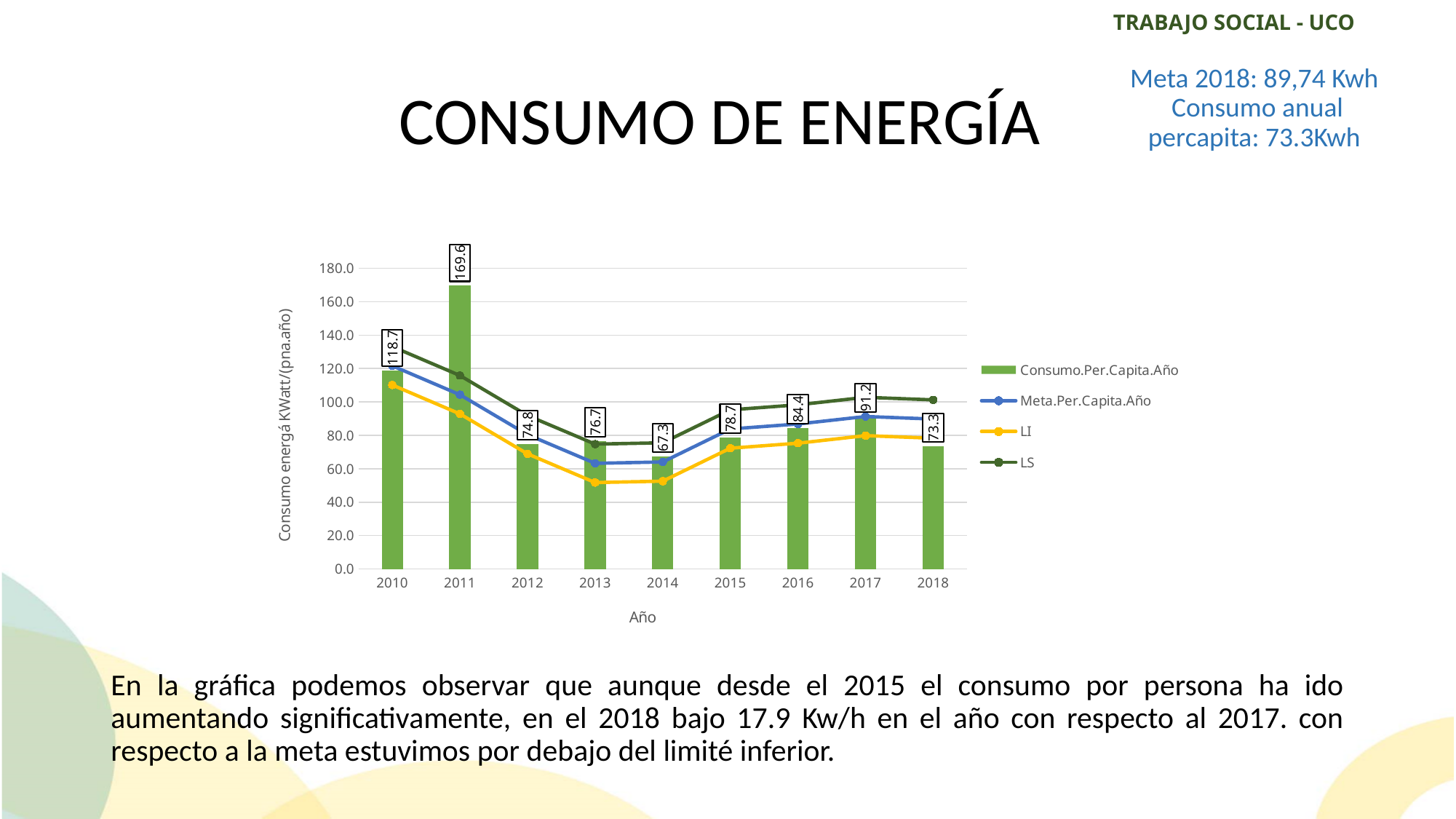
Do the Consumo.Per.Capita.Año bars rise or fall from 2014 to 2017? rise Which year has the highest Consumo.Per.Capita.Año bar? 2011 What is the title of the y axis of the chart? Consumo energá KWatt/(pna.año) What is the Consumo.Per.Capita.Año value for 2011? 169.6 How many years are shown on the x axis of the chart? 9 Which year has a larger Consumo.Per.Capita.Año value, 2012 or 2013? 2013 What is the Consumo.Per.Capita.Año value for 2018? 73.3 Which year has the lowest Consumo.Per.Capita.Año bar? 2014 How many series does the chart legend list? 4 What is the difference between the Consumo.Per.Capita.Año values for 2017 and 2018? 17.9 Is the LS value for 2010 greater or less than 120? greater Is the LI value for 2013 greater or less than 60? less